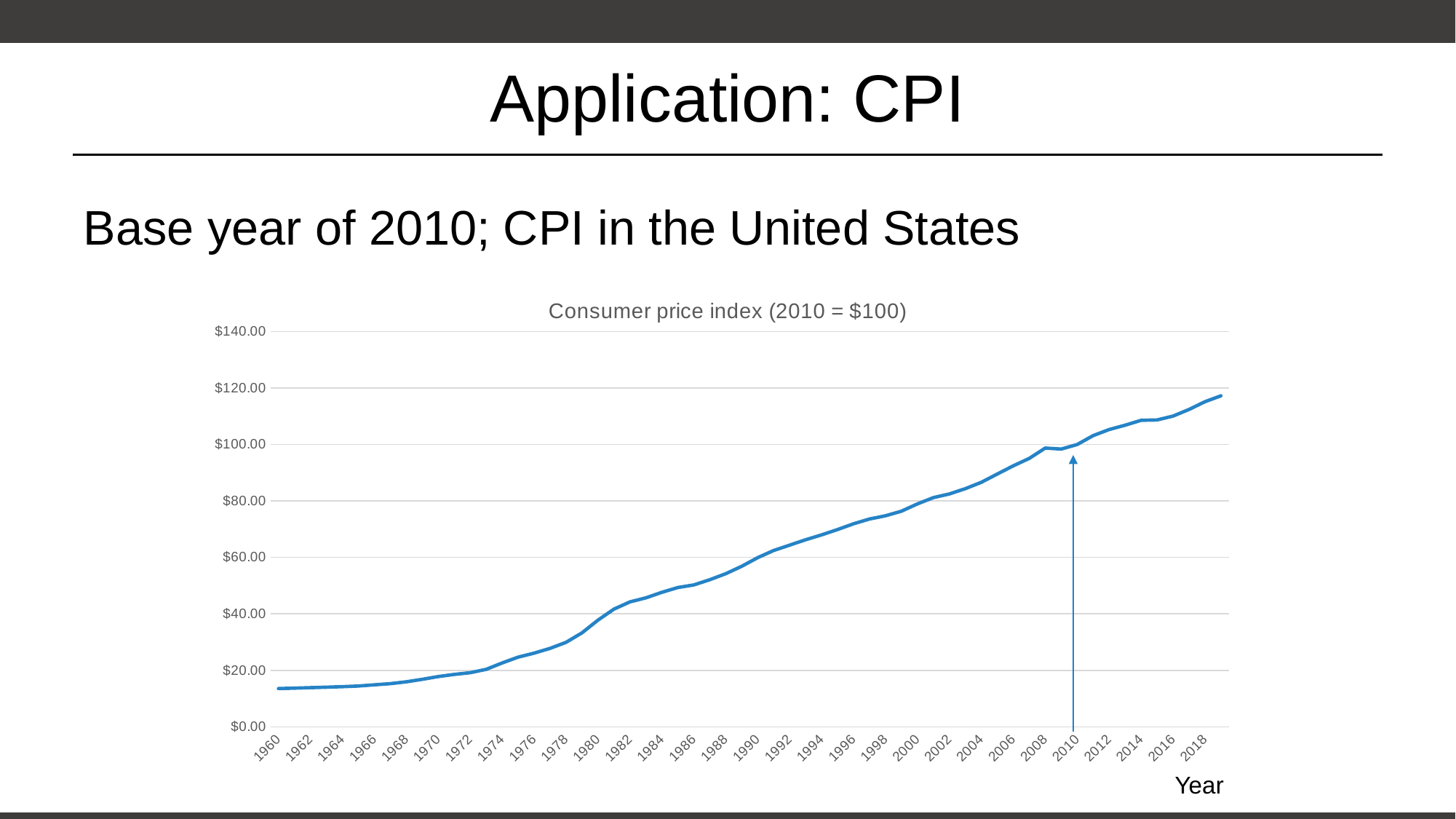
Is the value for 1980 greater or less than $60.00? less Is the value for 1960 greater or less than $20.00? less What is the title of the chart? Consumer price index (2010 = $100) What kind of chart is shown on the slide? line chart Which year has the larger value, 1976 or 2000? 2000 What is the label of the x axis? Year Is the value for 2018 greater or less than $100.00? greater What is the consumer price index value for the base year 2010? $100.00 Which year has the lowest consumer price index value? 1960 Do the values rise or fall from 1960 to 2018? rise